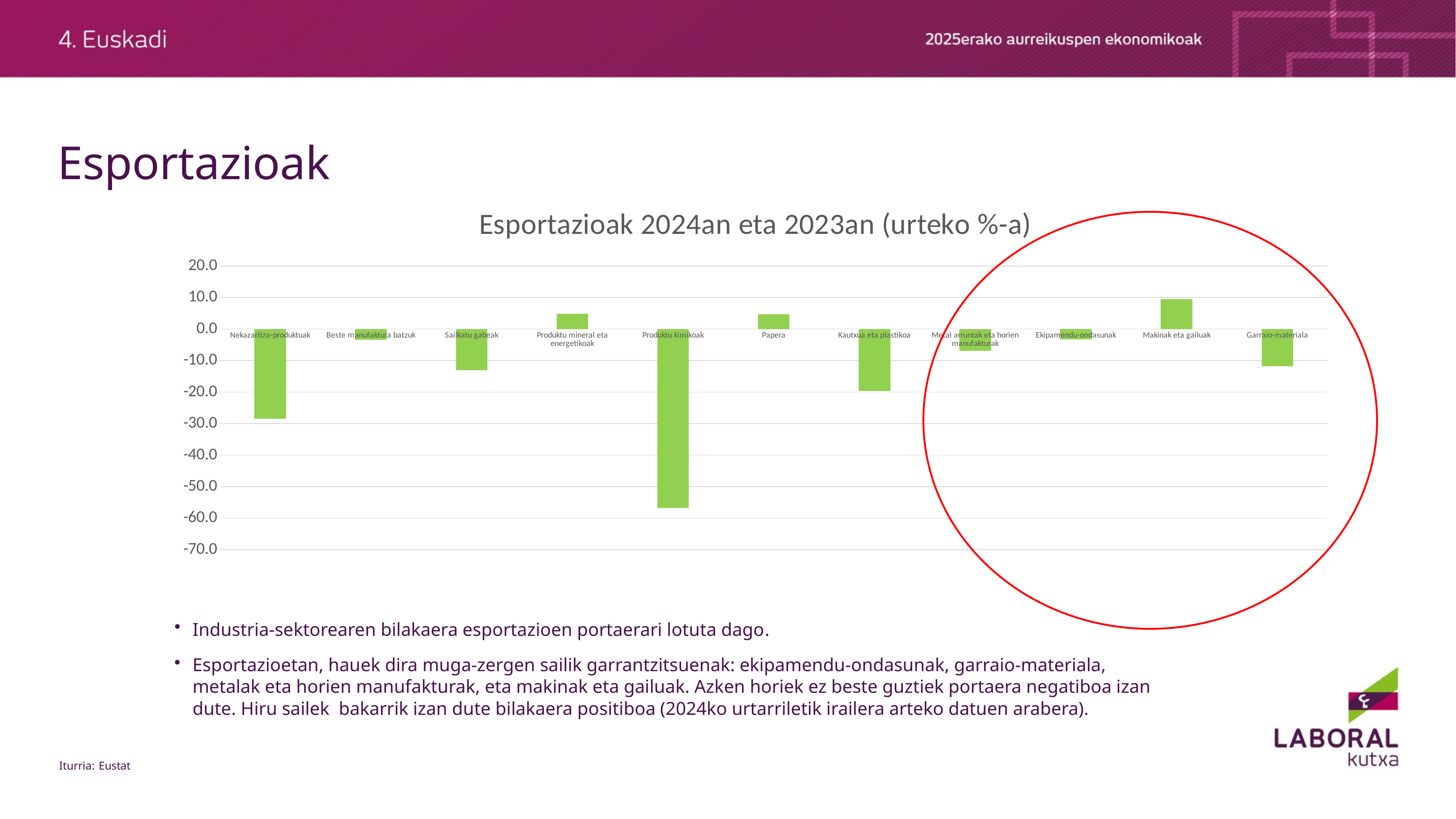
How many categories in the chart have a positive value? 3 Which is larger, the value for Makinak eta gailuak or the value for Papera? Makinak eta gailuak Is the value for Makinak eta gailuak greater or less than 0.0? greater Which category has the highest value in the chart? Makinak eta gailuak Is the value for Nekazaritza-produktuak greater or less than -20.0? less What is the title of the chart? Esportazioak 2024an eta 2023an (urteko %-a) How many categories are plotted in the chart? 11 Is the value for Produktu kimikoak greater or less than -50.0? less Which is larger, the value for Sailkatu gabeak or the value for Nekazaritza-produktuak? Sailkatu gabeak What kind of chart is shown on the slide? bar chart Which category has the lowest value in the chart? Produktu kimikoak